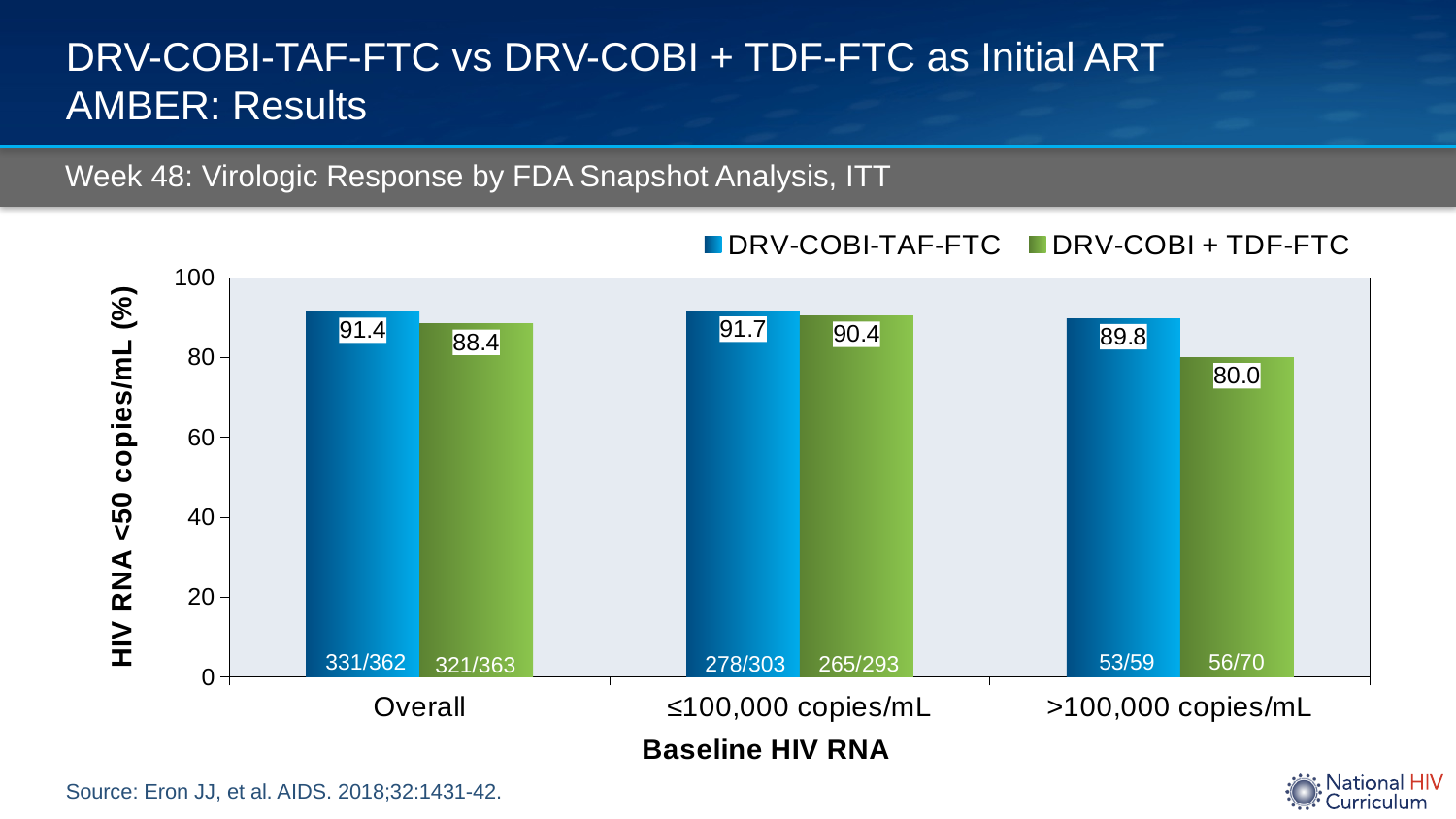
In the Overall category, which series has the larger value? DRV-COBI-TAF-FTC How many series does the legend list? 2 What is the value for DRV-COBI + TDF-FTC in the ≤100,000 copies/mL category? 90.4 How many baseline HIV RNA categories are shown on the x axis? 3 What is the difference between the DRV-COBI-TAF-FTC and DRV-COBI + TDF-FTC values in the >100,000 copies/mL category? 9.8 What is the y-axis label of the chart? HIV RNA <50 copies/mL (%) What fraction is shown at the base of the DRV-COBI-TAF-FTC bar in the >100,000 copies/mL category? 53/59 What is the value for DRV-COBI + TDF-FTC in the >100,000 copies/mL category? 80.0 Which category has the highest value for DRV-COBI-TAF-FTC? ≤100,000 copies/mL What kind of chart is shown on the slide? Bar chart What is the value for DRV-COBI-TAF-FTC in the Overall category? 91.4 Which category has the lowest value for DRV-COBI + TDF-FTC? >100,000 copies/mL